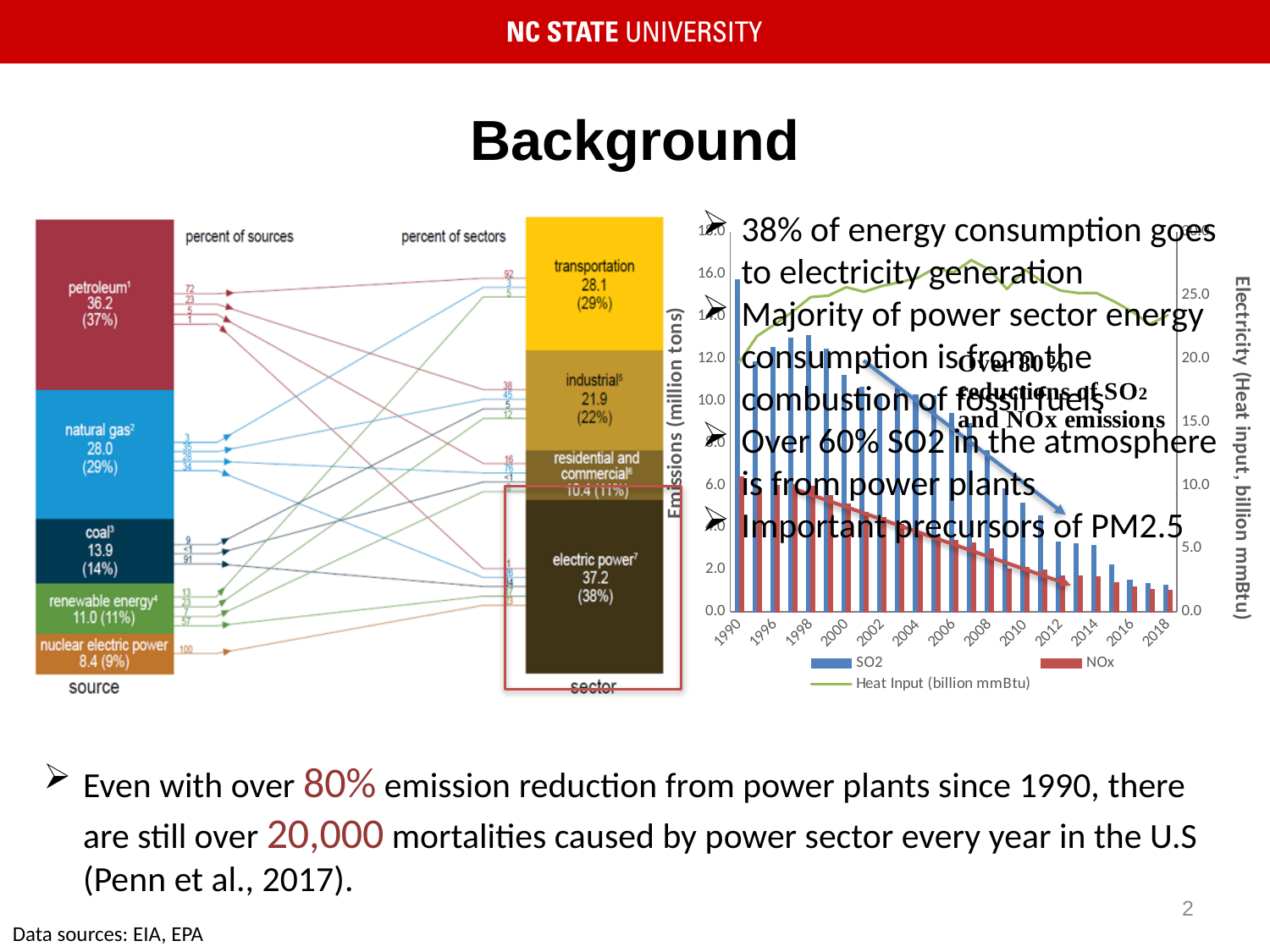
In the energy flow diagram on the left, which source has the highest value? petroleum In the emissions chart on the right, is the SO2 value for 2018 greater or less than 4.0 million tons? less In the energy flow diagram on the left, which source has the lowest value? nuclear electric power How many series does the legend of the emissions chart on the right list? 3 In the emissions chart on the right, do the SO2 bars rise or fall from 1990 to 2018? fall In the emissions chart on the right, what kind of chart is used to show the SO2 and NOx series? bar chart In the energy flow diagram on the left, what is the difference between the petroleum value (36.2) and the natural gas value (28.0)? 8.2 In the emissions chart on the right, is the SO2 value for 1990 greater or less than 10.0 million tons? greater In the emissions chart on the right, which series is plotted as a line rather than bars? Heat Input (billion mmBtu) In the energy flow diagram on the left, what percentage is shown for the electric power sector? 38% In the emissions chart on the right, which is larger in 1990, the SO2 bar or the NOx bar? SO2 In the emissions chart on the right, what is the label of the left vertical axis? Emissions (million tons)